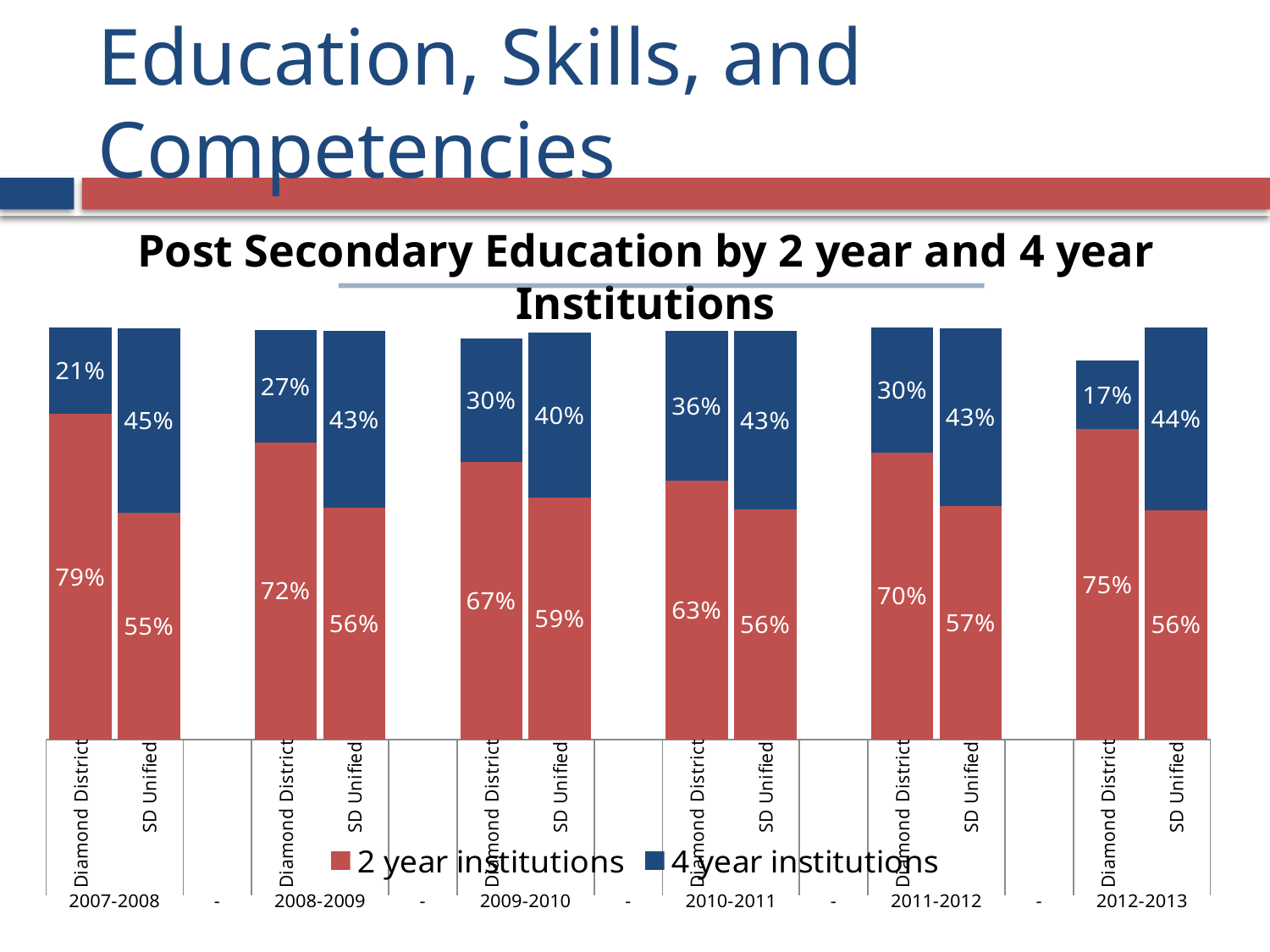
What is the 4 year institutions value for SD Unified in 2012-2013? 44% Which has the larger 4 year institutions value in 2009-2010, Diamond District or SD Unified? SD Unified How many series does the legend list? 2 What is the 2 year institutions value for Diamond District in 2007-2008? 79% What is the difference between the 2 year institutions values for Diamond District and SD Unified in 2007-2008? 24% What is the title of the chart? Post Secondary Education by 2 year and 4 year Institutions What type of chart is shown on the slide? stacked bar chart How many school years are shown on the x axis? 6 What is the 4 year institutions value for Diamond District in 2010-2011? 36% In which year does Diamond District have its lowest 4 year institutions value? 2012-2013 What is the total of the stacked bar for Diamond District in 2007-2008? 100% In which year does Diamond District have its highest 2 year institutions value? 2007-2008